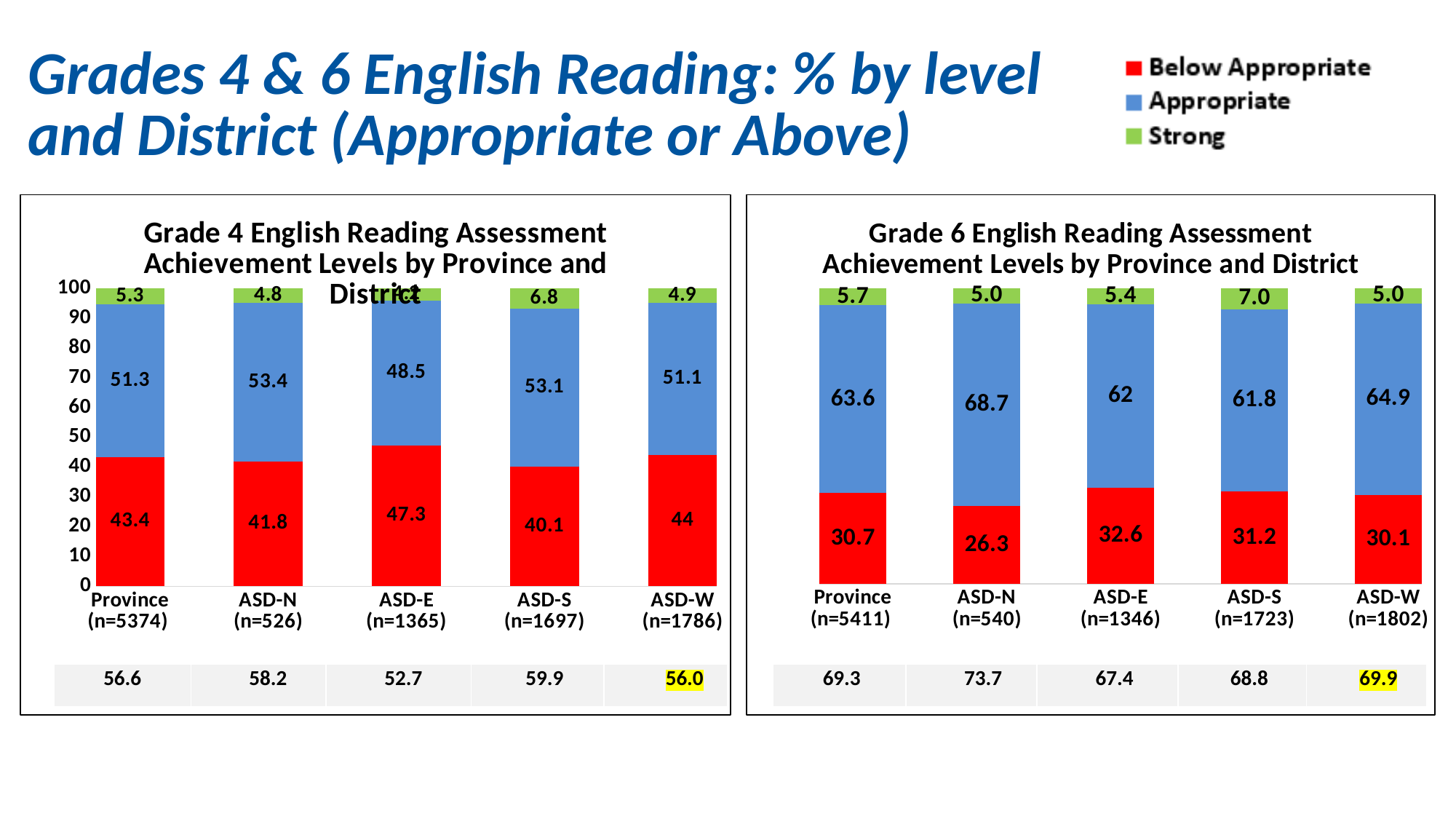
In the Grade 4 English Reading Assessment chart, which district or province has the lowest Below Appropriate value? ASD-S (n=1697) What kind of chart is the Grade 4 English Reading Assessment chart? Stacked bar chart In the Grade 6 English Reading Assessment chart, which is larger: the Strong value for ASD-S or the Strong value for Province? ASD-S In the Grade 4 English Reading Assessment chart, what is the Strong value for ASD-S (n=1697)? 6.8 How many series does the legend at the top right of the slide list? 3 Which colour represents the Strong level in the legend? Green In the Grade 6 English Reading Assessment chart, what is the Appropriate value for ASD-N (n=540)? 68.7 How many categories (province and districts) are shown on the x axis of the Grade 6 English Reading Assessment chart? 5 In the Grade 6 English Reading Assessment chart, what is the combined Appropriate and Strong value for ASD-W (n=1802)? 69.9 In the Grade 4 English Reading Assessment chart, what is the Below Appropriate value for ASD-E (n=1365)? 47.3 In the Grade 4 English Reading Assessment chart, what is the difference between the Below Appropriate values for ASD-E and ASD-S? 7.2 In the Grade 6 English Reading Assessment chart, which district or province has the highest Below Appropriate value? ASD-E (n=1346)